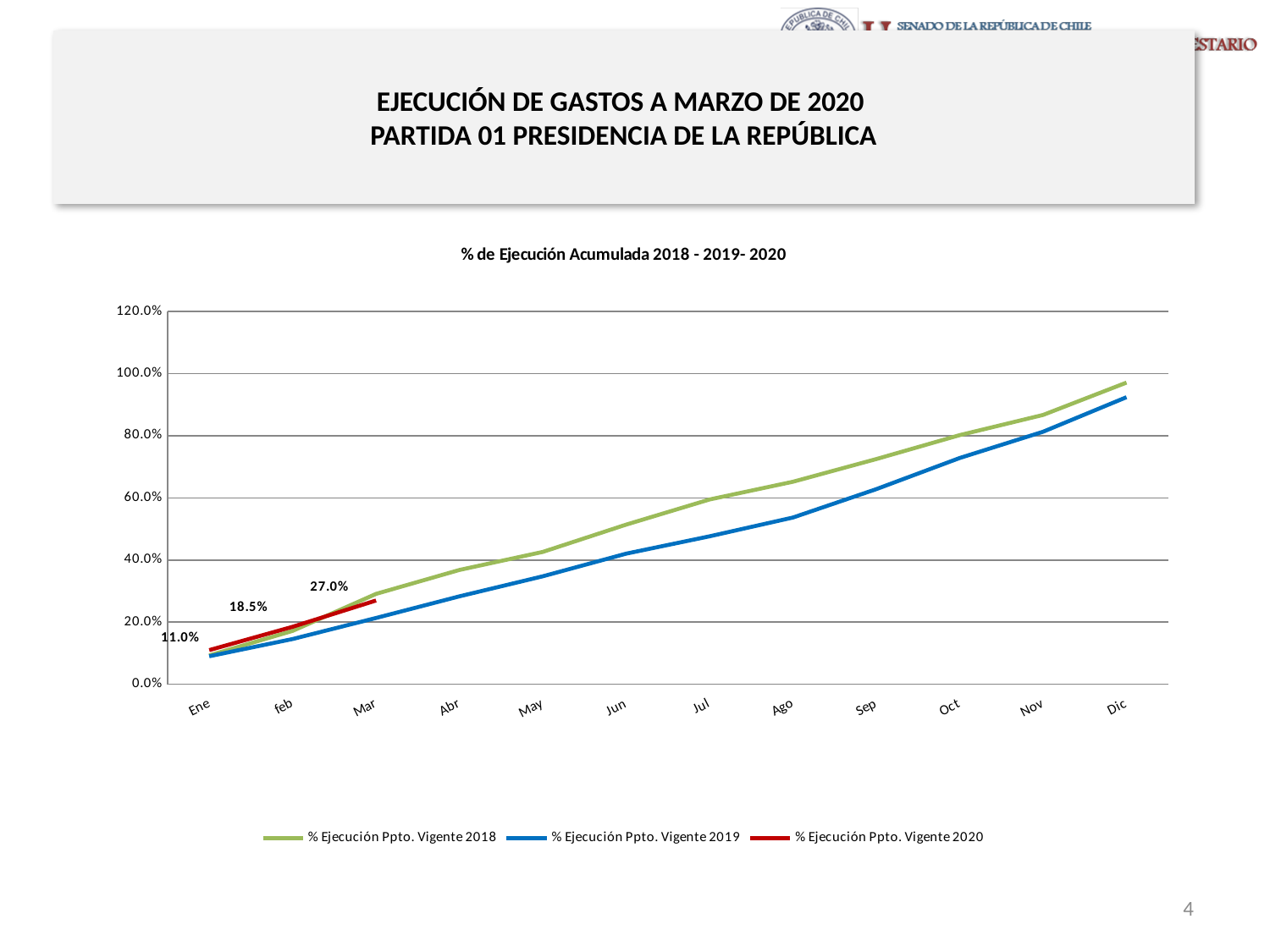
In Dic, which series is higher: % Ejecución Ppto. Vigente 2018 or % Ejecución Ppto. Vigente 2019? % Ejecución Ppto. Vigente 2018 What is the value of % Ejecución Ppto. Vigente 2020 for feb? 18.5% Is the value for % Ejecución Ppto. Vigente 2018 in Dic greater or less than 80.0%? greater How many months are shown on the x axis of the chart? 12 Do the values of % Ejecución Ppto. Vigente 2019 rise or fall from Ene to Dic? Rise What kind of chart is shown on the slide? Line chart Is the value for % Ejecución Ppto. Vigente 2019 in Jul greater or less than 60.0%? less What is the difference between the feb and Ene values of % Ejecución Ppto. Vigente 2020? 7.5% How many series does the legend list? 3 What is the value of % Ejecución Ppto. Vigente 2020 for Mar? 27.0% What is the difference between the Mar and Ene values of % Ejecución Ppto. Vigente 2020? 16.0% What is the value of % Ejecución Ppto. Vigente 2020 for Ene? 11.0%